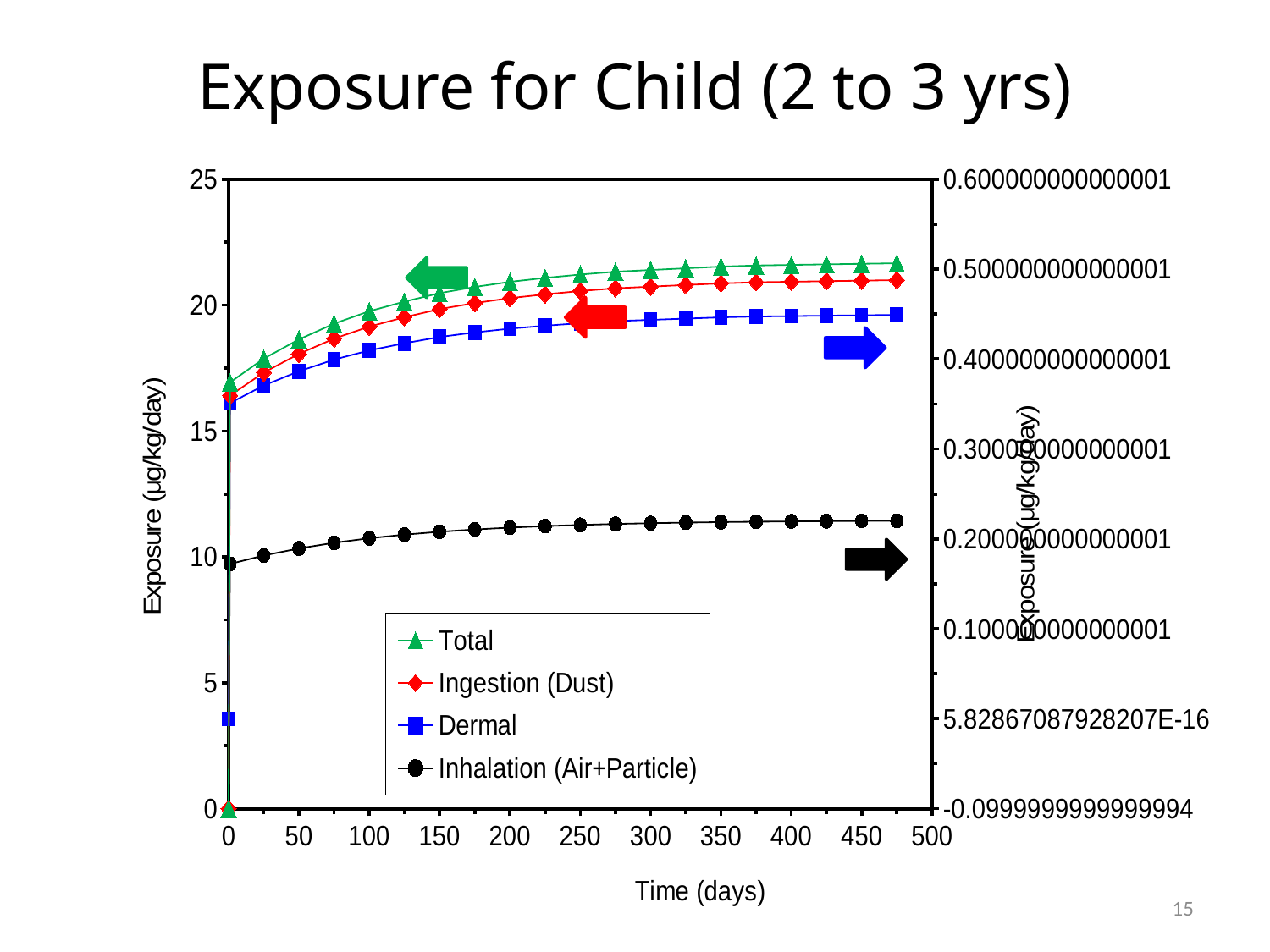
At 475 days, which is larger, Total or Ingestion (Dust)? Total On the left axis, is the value for Total at 475 days greater or less than 20? greater Which series is plotted lowest on the chart? Inhalation (Air+Particle) What is the title of the chart? Exposure for Child (2 to 3 yrs) Which series is plotted with green triangle markers? Total What kind of chart is shown on the slide? line chart What is the label of the x axis? Time (days) How many series does the legend list? 4 On the left axis, is the value for Ingestion (Dust) at 25 days greater or less than 15? greater Does the Total series rise or fall as time increases? rise Which series has the highest values across the time range? Total